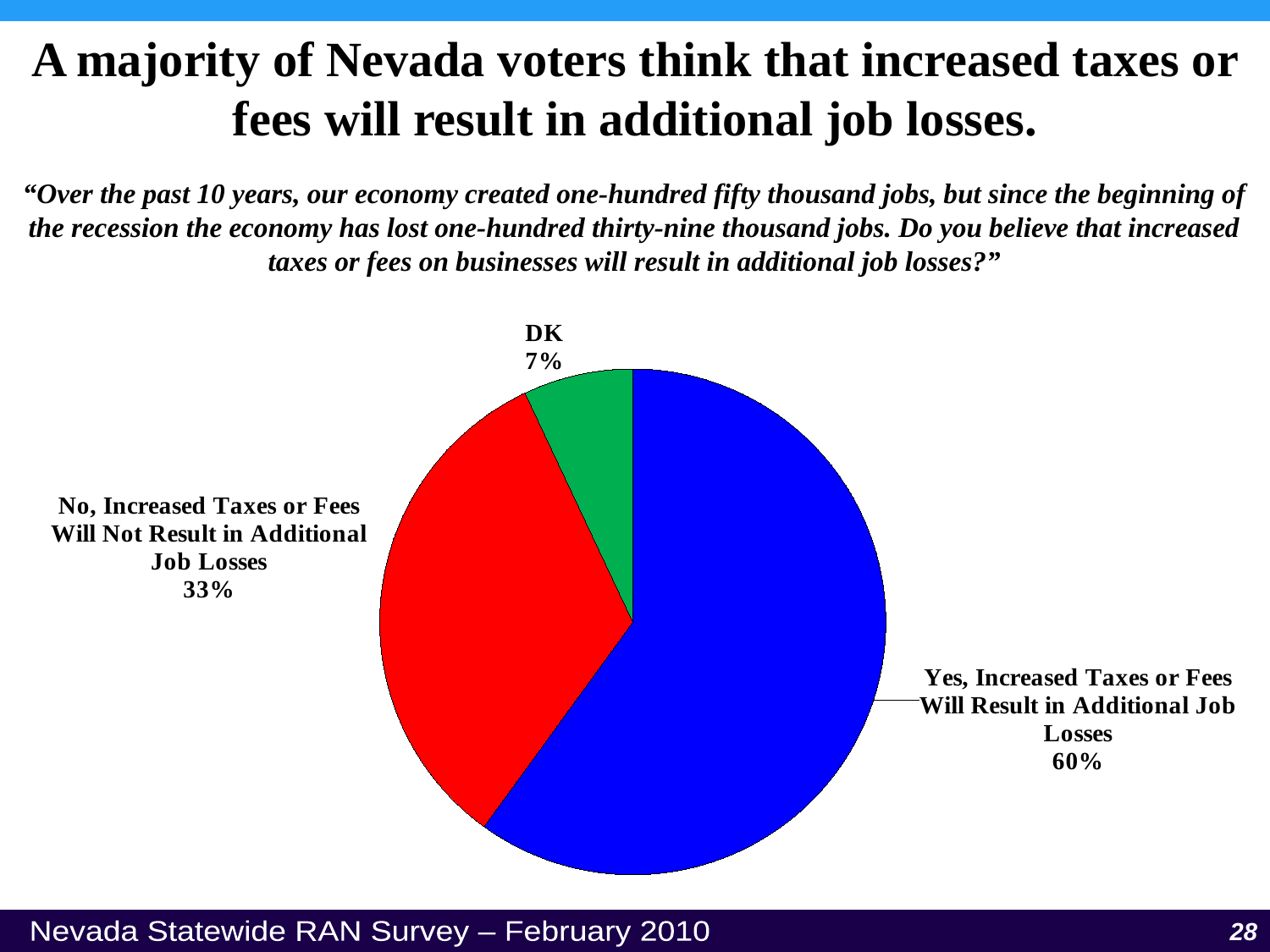
What percentage of voters answered DK? 7% What is the difference in percentage points between the Yes and No responses? 27 What is the difference in percentage points between the No response and DK? 26 What percentage of voters said no, increased taxes or fees will not result in additional job losses? 33% What percentage of Nevada voters said yes, increased taxes or fees will result in additional job losses? 60% What colour is the slice for the Yes response? Blue What kind of chart is shown on the slide? Pie chart Which is larger, the share for No or the share for DK? No How many slices does the pie chart have? 3 Which response has the smallest share of the pie? DK What colour is the DK slice? Green Which response has the largest share of the pie? Yes, Increased Taxes or Fees Will Result in Additional Job Losses